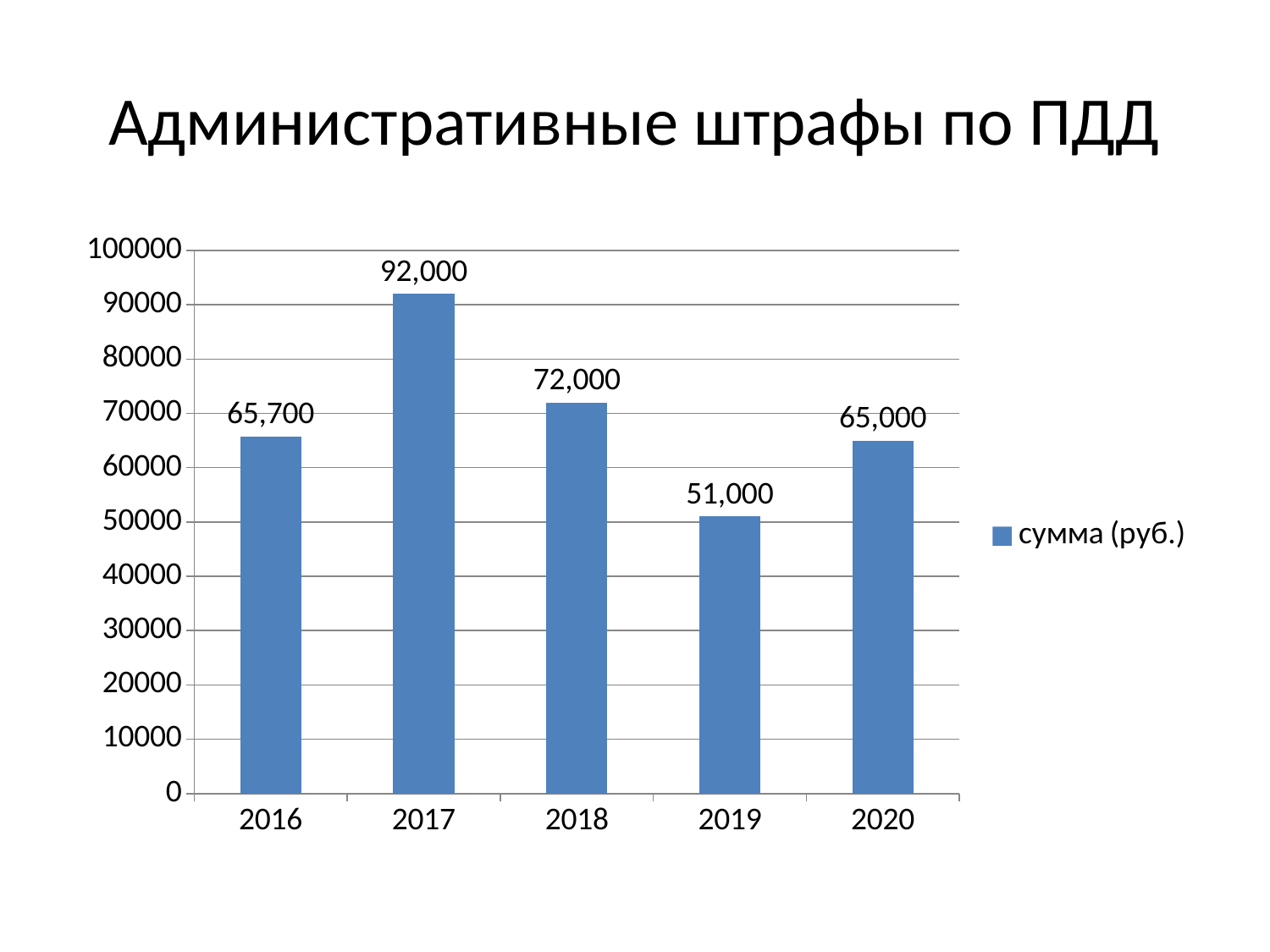
How many years are shown on the x axis? 5 What is the difference between the values for 2017 and 2018? 20,000 Which year has the highest value? 2017 Which year has the lowest value? 2019 Which is larger, the value for 2018 or the value for 2020? 2018 What is the value for 2020? 65,000 What kind of chart is shown on the slide? bar chart What is the title of the chart? Административные штрафы по ПДД What is the value for 2016? 65,700 Is the value for 2017 greater or less than 90000? greater What is the difference between the values for 2016 and 2020? 700 What is the value for 2019? 51,000